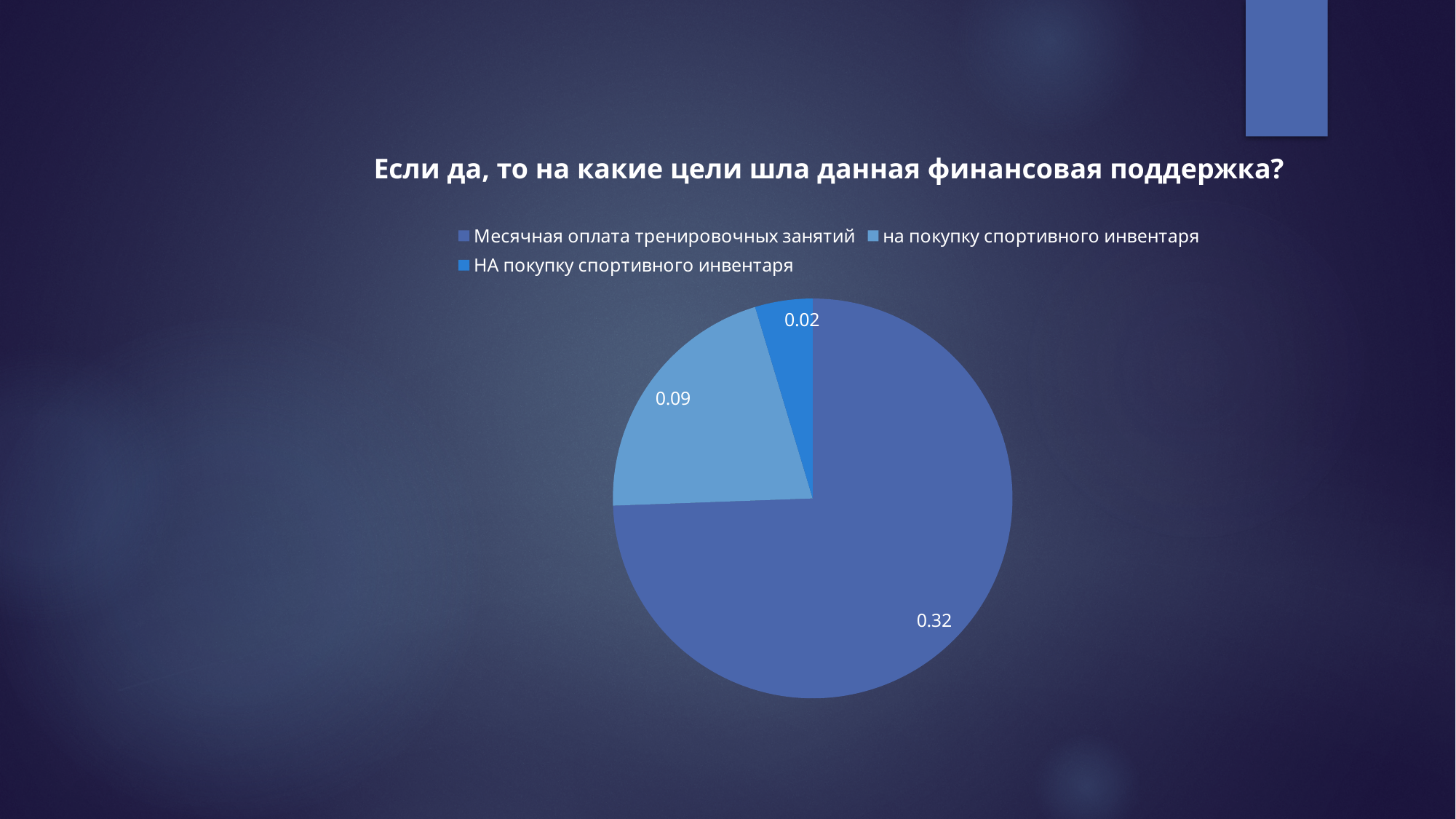
What is the difference between the slice labelled 0.09 and the slice labelled 0.02? 0.07 What value is printed on the smallest slice of the pie? 0.02 How many slices does the pie chart have? 3 What kind of chart is shown on the slide? pie chart What is the difference between the largest slice value (0.32) and the slice labelled 0.09? 0.23 What is the title of the chart? Если да, то на какие цели шла данная финансовая поддержка? How many entries does the chart legend list? 3 What value is shown for the legend entry written in lowercase, "на покупку спортивного инвентаря"? 0.09 Which category has the largest slice of the pie? Месячная оплата тренировочных занятий Which is larger: the slice for "Месячная оплата тренировочных занятий" or the slice labelled 0.09? Месячная оплата тренировочных занятий What value is shown for "Месячная оплата тренировочных занятий"? 0.32 What is the sum of the three values printed on the pie slices? 0.43